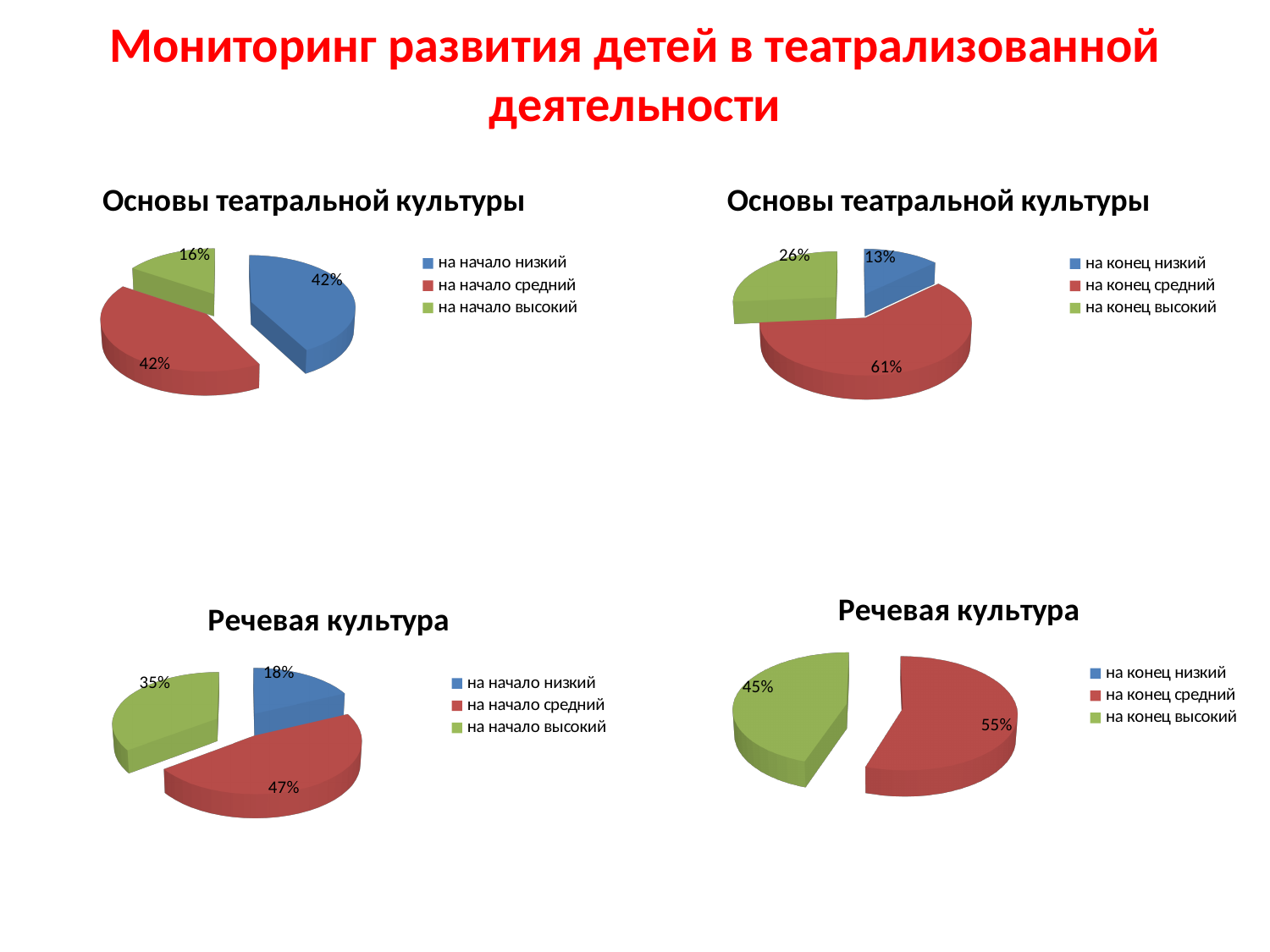
In the bottom-left pie chart (Речевая культура, на начало), which slice is the smallest? на начало низкий What type of chart is used for all four charts on the slide? Pie chart In the top-right pie chart (Основы театральной культуры, на конец), which slice is the smallest? на конец низкий In the bottom-left pie chart (Речевая культура, на начало), what is the difference between the 'на начало высокий' and 'на начало низкий' shares? 17% In the bottom-left pie chart (Речевая культура, на начало), what share is labelled for 'на начало средний'? 47% In the bottom-right pie chart (Речевая культура, на конец), what share is labelled for 'на конец высокий'? 45% In the top-right pie chart (Основы театральной культуры, на конец), which slice is the largest? на конец средний In the top-right pie chart (Основы театральной культуры, на конец), what share is labelled for 'на конец средний'? 61% In the top-right pie chart (Основы театральной культуры, на конец), what share is labelled for 'на конец низкий'? 13% In the top-left pie chart (Основы театральной культуры, на начало), what share is labelled for 'на начало высокий'? 16% In the top-left pie chart (Основы театральной культуры, на начало), what share is labelled for 'на начало низкий'? 42% In the bottom-right pie chart (Речевая культура, на конец), which is larger: 'на конец средний' or 'на конец высокий'? на конец средний